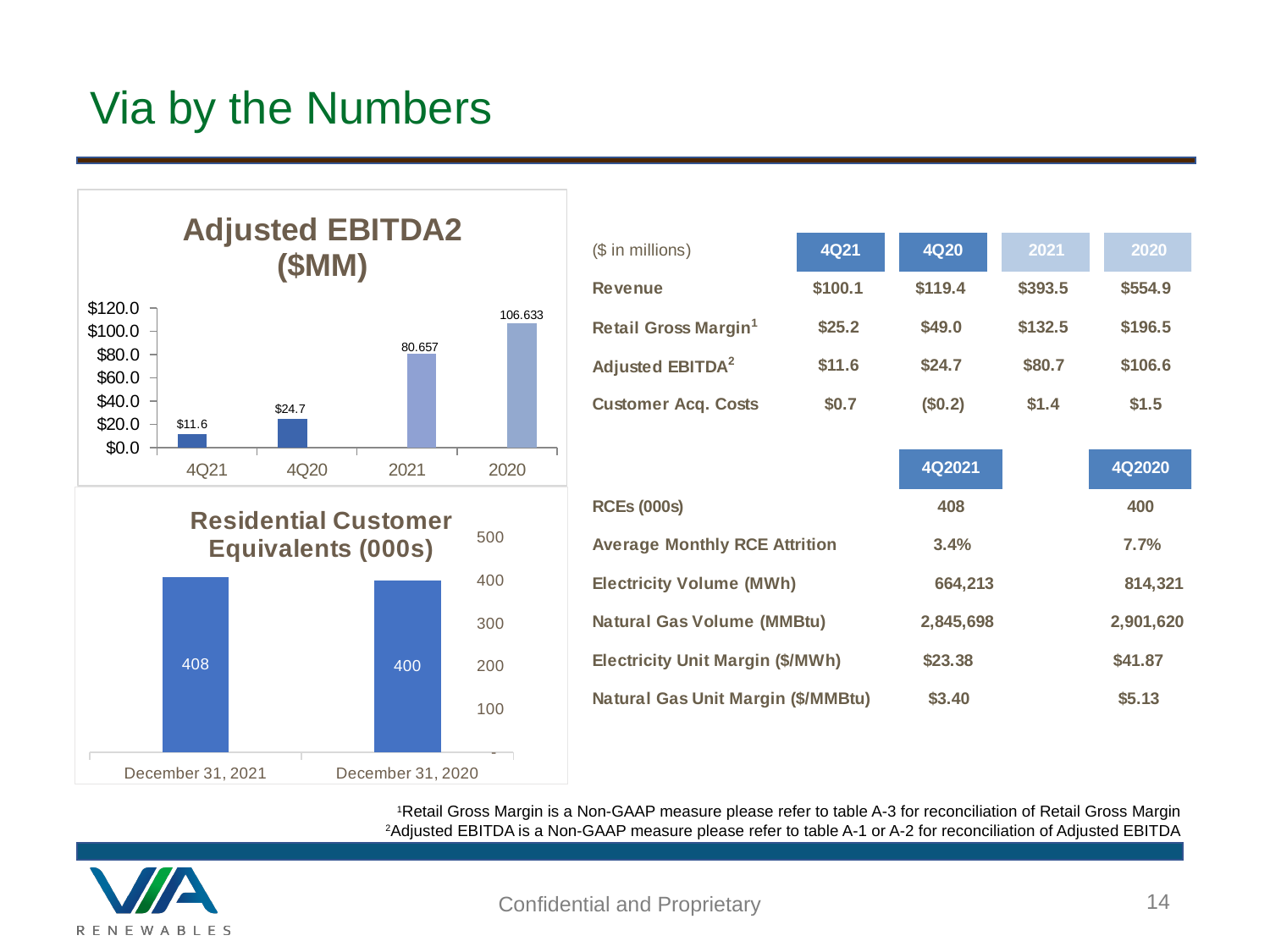
In the Residential Customer Equivalents (000s) chart, what is the value for December 31, 2021? 408 In the Adjusted EBITDA2 ($MM) chart, what is the difference between the 4Q20 and 4Q21 values? $13.1 How many categories are shown in the Adjusted EBITDA2 ($MM) chart? 4 In the Adjusted EBITDA2 ($MM) chart, which category has the lowest value? 4Q21 In the Residential Customer Equivalents (000s) chart, which is larger, December 31, 2021 or December 31, 2020? December 31, 2021 In the Adjusted EBITDA2 ($MM) chart, is the value for 2021 greater or less than $100.0? less In the Adjusted EBITDA2 ($MM) chart, what is the value for 2020? 106.633 In the Adjusted EBITDA2 ($MM) chart, which category has the highest value? 2020 In the Adjusted EBITDA2 ($MM) chart, what is the value for 2021? 80.657 In the Adjusted EBITDA2 ($MM) chart, what is the value for 4Q21? $11.6 In the Residential Customer Equivalents (000s) chart, what is the difference between the December 31, 2021 and December 31, 2020 values? 8 What kind of chart is the Residential Customer Equivalents (000s) chart? bar chart